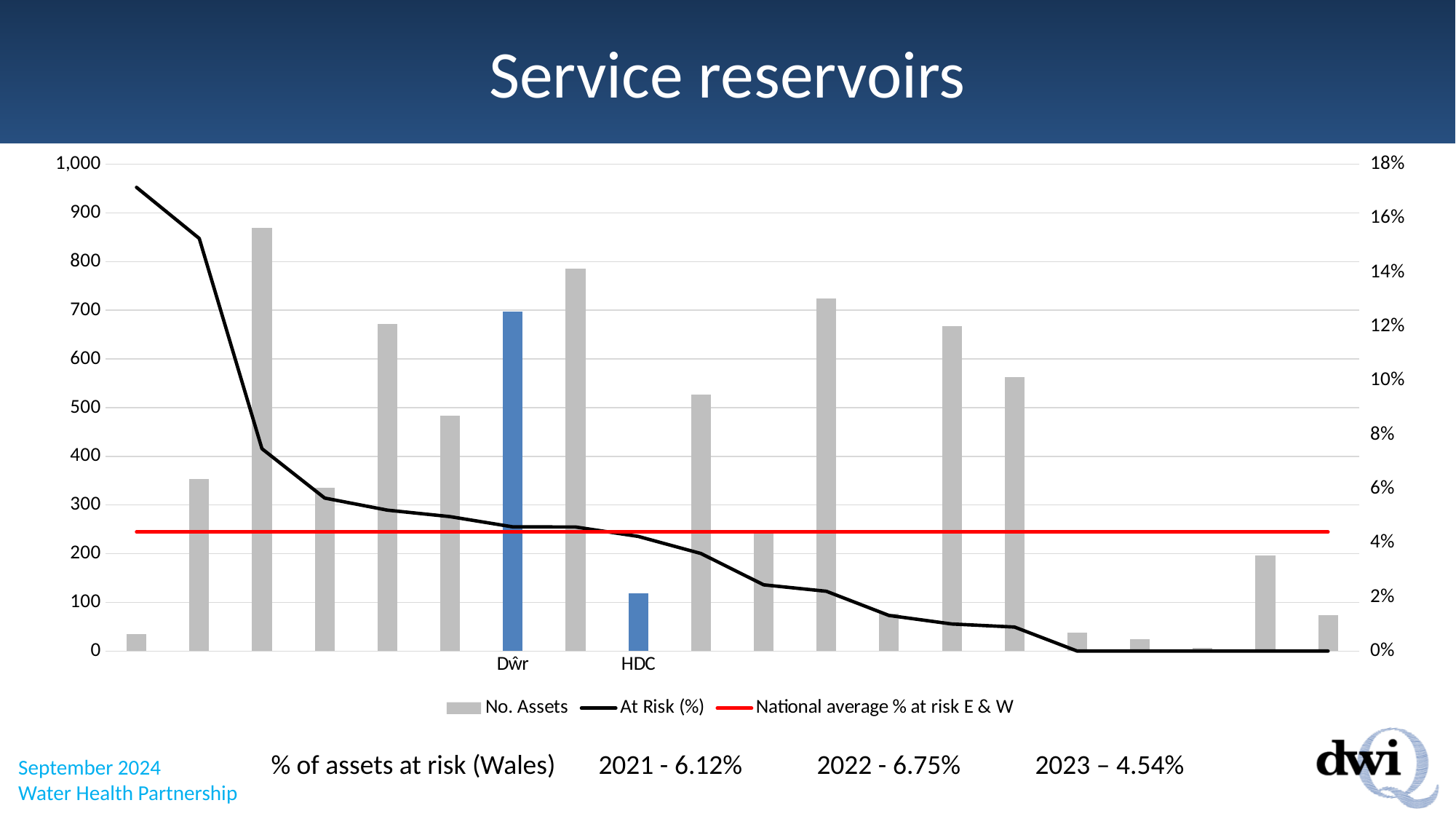
Is the At Risk (%) value for HDC greater or less than 8%? less What kind of chart is this? Combined bar and line chart Is the National average % at risk E & W line greater or less than 6%? less Which has more assets, Dŵr or HDC? Dŵr What is the highest value shown on the right-hand percentage axis? 18% Is the No. Assets value for Dŵr greater or less than 600? greater How many series does the legend list? 3 How many bars are plotted for No. Assets? 20 Does the At Risk (%) line rise or fall from left to right? Falls What colour are the bars for Dŵr and HDC? Blue